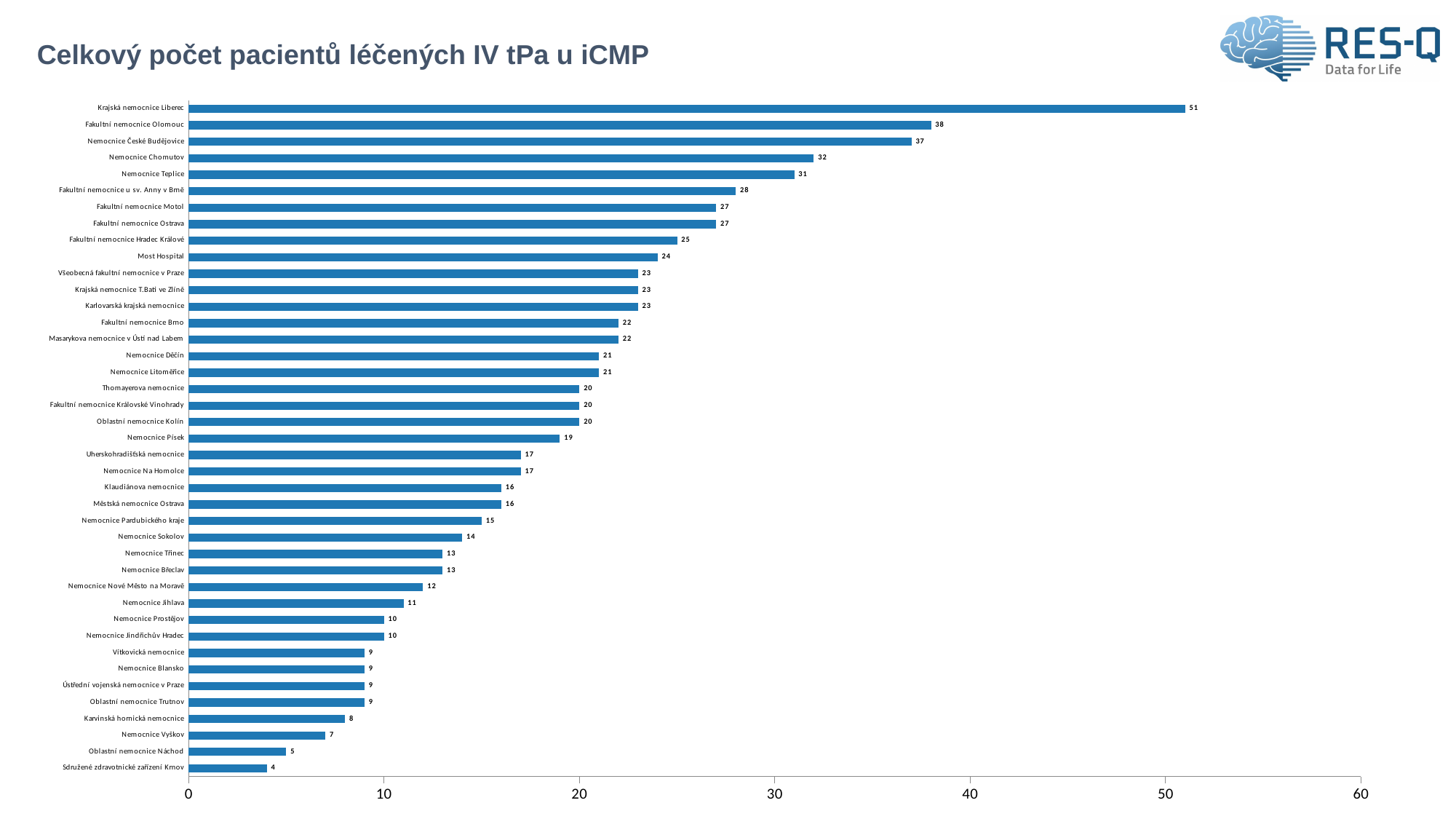
Which hospital has the highest value? Krajská nemocnice Liberec Is the value for Nemocnice České Budějovice greater or less than 30? greater What kind of chart is shown on the slide? bar chart Which is larger, the value for Fakultní nemocnice Hradec Králové or the value for Nemocnice Písek? Fakultní nemocnice Hradec Králové What is the value for Nemocnice Chomutov? 32 What is the value for Krajská nemocnice Liberec? 51 What is the difference between the values for Fakultní nemocnice Olomouc and Nemocnice Teplice? 7 Which hospital has the lowest value? Sdružené zdravotnické zařízení Krnov How many hospitals are shown in the chart? 41 What is the value for Nemocnice Jihlava? 11 What is the value for Most Hospital? 24 What is the title of the chart? Celkový počet pacientů léčených IV tPa u iCMP